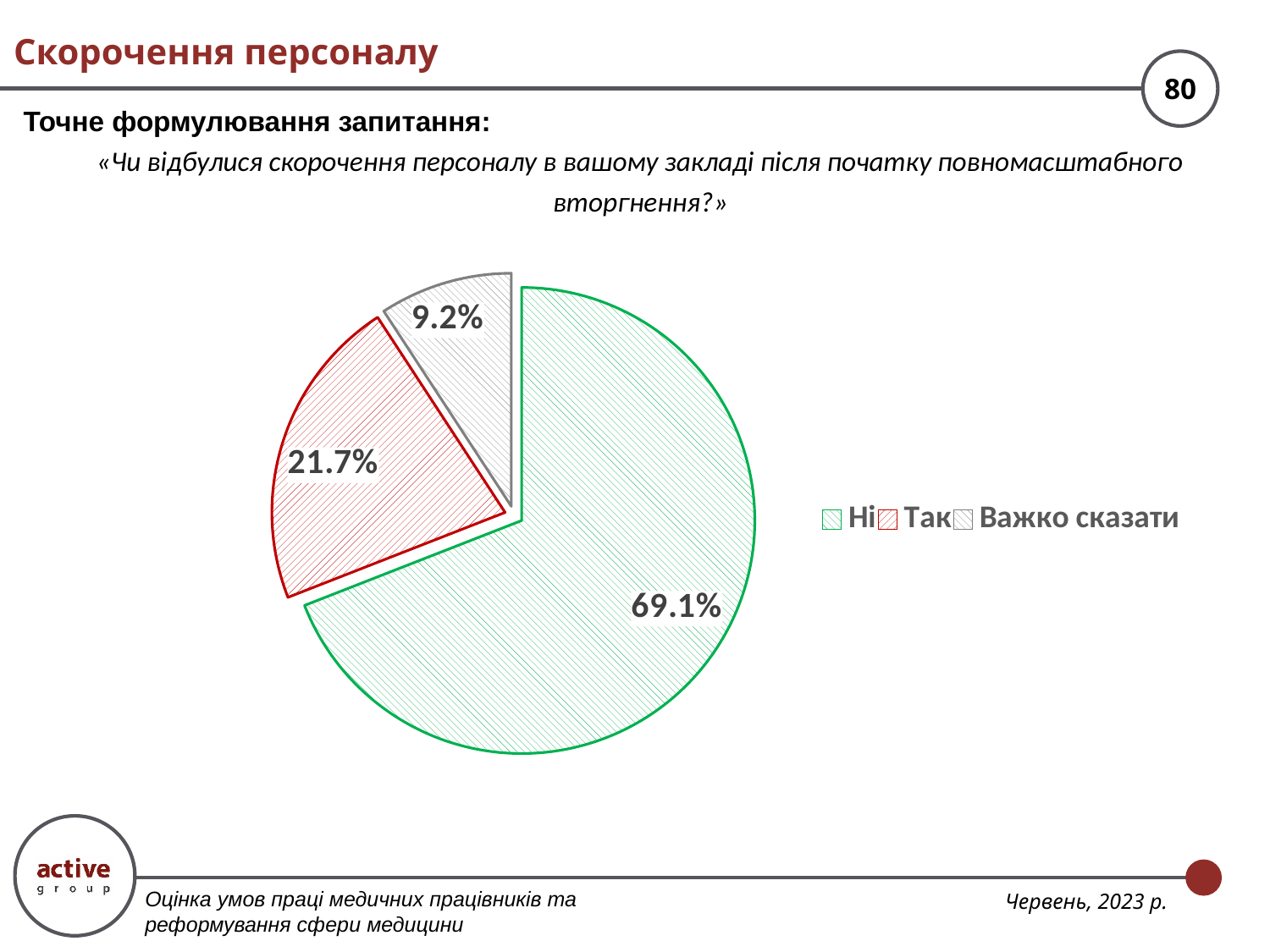
What colour is the outline of the "Так" slice? Red What type of chart is shown on the slide? Pie chart How many slices does the pie chart have? 3 What is the difference in percentage points between the "Ні" and "Так" slices? 47.4 What share of respondents answered "Важко сказати"? 9.2% Which slice is larger: "Так" or "Важко сказати"? Так Which answer option has the largest share of the pie? Ні What share of respondents answered "Так" (Yes)? 21.7% Which answer option has the smallest share of the pie? Важко сказати What share of respondents answered "Ні" (No)? 69.1% What is the difference in percentage points between the "Так" and "Важко сказати" slices? 12.5 How many entries does the legend list? 3